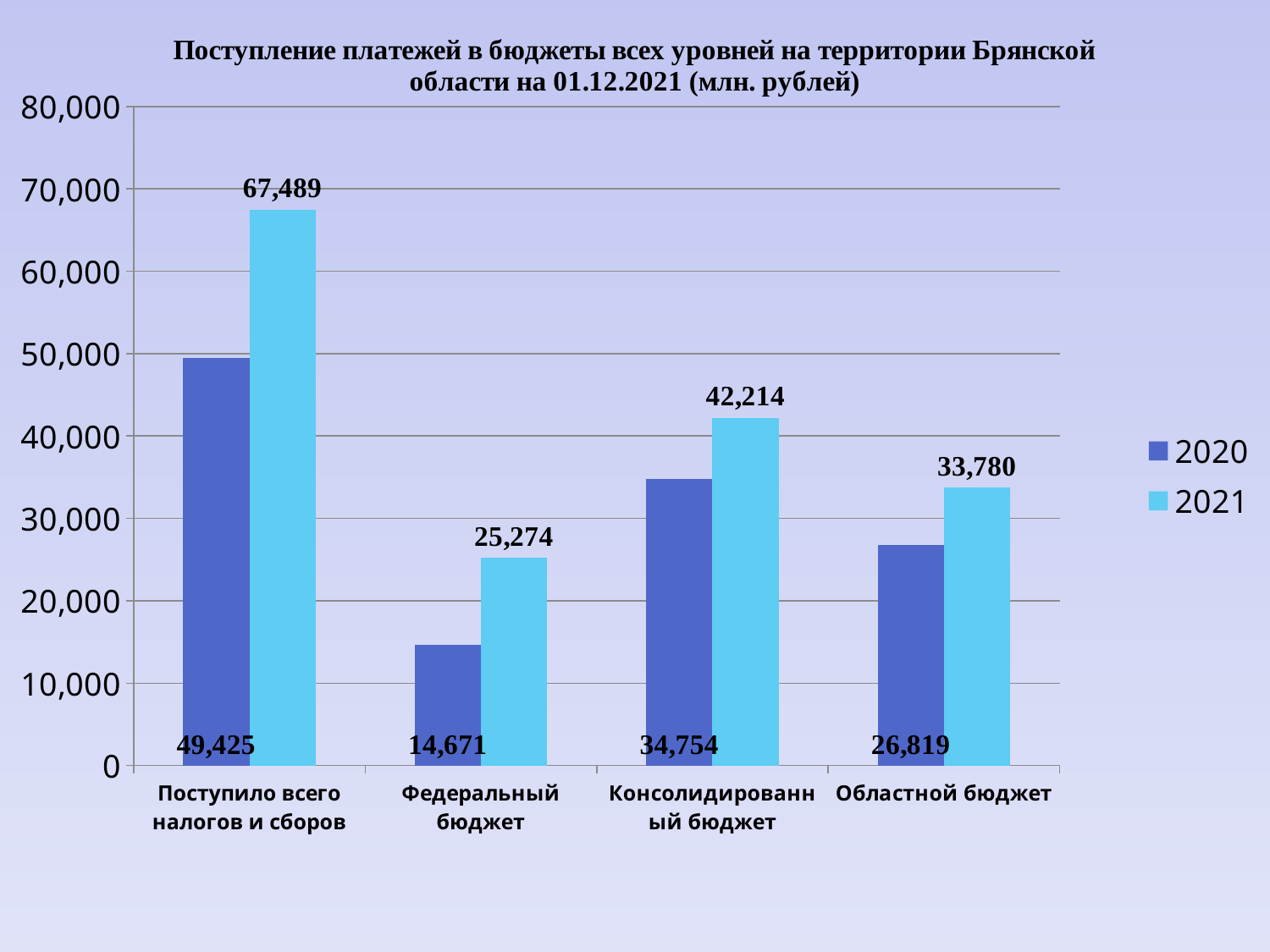
What kind of chart is shown on the slide? bar chart What is the 2020 value for Федеральный бюджет? 14,671 What is the 2020 value for Областной бюджет? 26,819 What is the 2021 value for Поступило всего налогов и сборов? 67,489 Which category has the lowest 2021 value? Федеральный бюджет What is the difference between the 2021 and 2020 values for Федеральный бюджет? 10,603 How many categories are shown on the x axis? 4 What is the 2021 value for Консолидированный бюджет? 42,214 Which category has the highest 2020 value? Поступило всего налогов и сборов Which is larger for Областной бюджет: the 2020 value or the 2021 value? 2021 Is the 2020 value for Консолидированный бюджет greater or less than 30,000? greater How many series does the legend list? 2